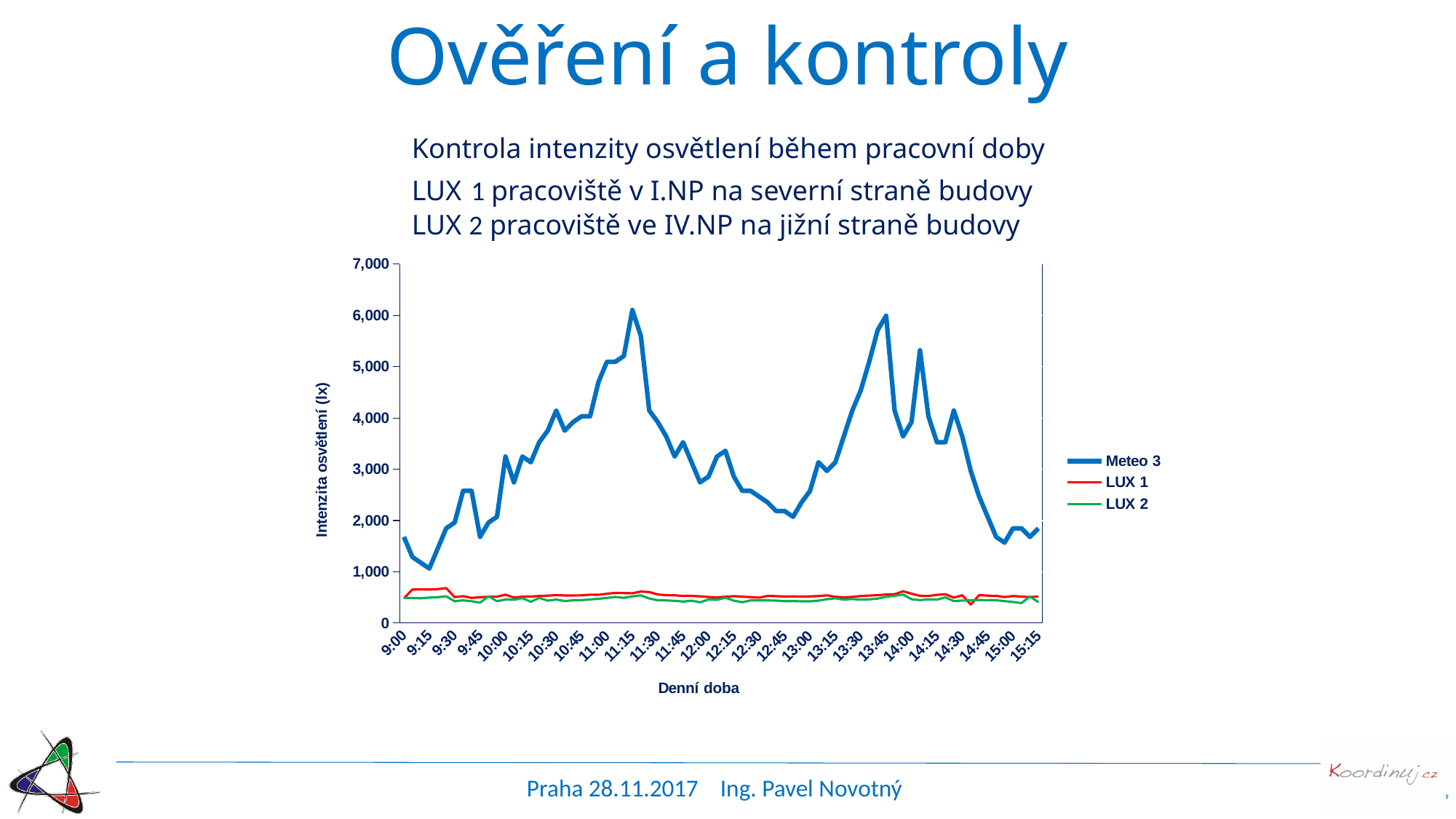
How many series does the chart legend list? 3 What is the title of the vertical axis? Intenzita osvětlení (lx) Is the value of Meteo 3 at 9:15 greater or less than 2,000? less Is the value of Meteo 3 at 11:15 greater or less than 5,000? greater Does the Meteo 3 line rise or fall between 14:15 and 15:00? fall Which series has the highest values throughout the chart? Meteo 3 Is the value of LUX 1 at 12:00 greater or less than 1,000? less What kind of chart is shown on the slide? line chart At 11:00, which series has the larger value, Meteo 3 or LUX 2? Meteo 3 What is the title of the horizontal axis? Denní doba